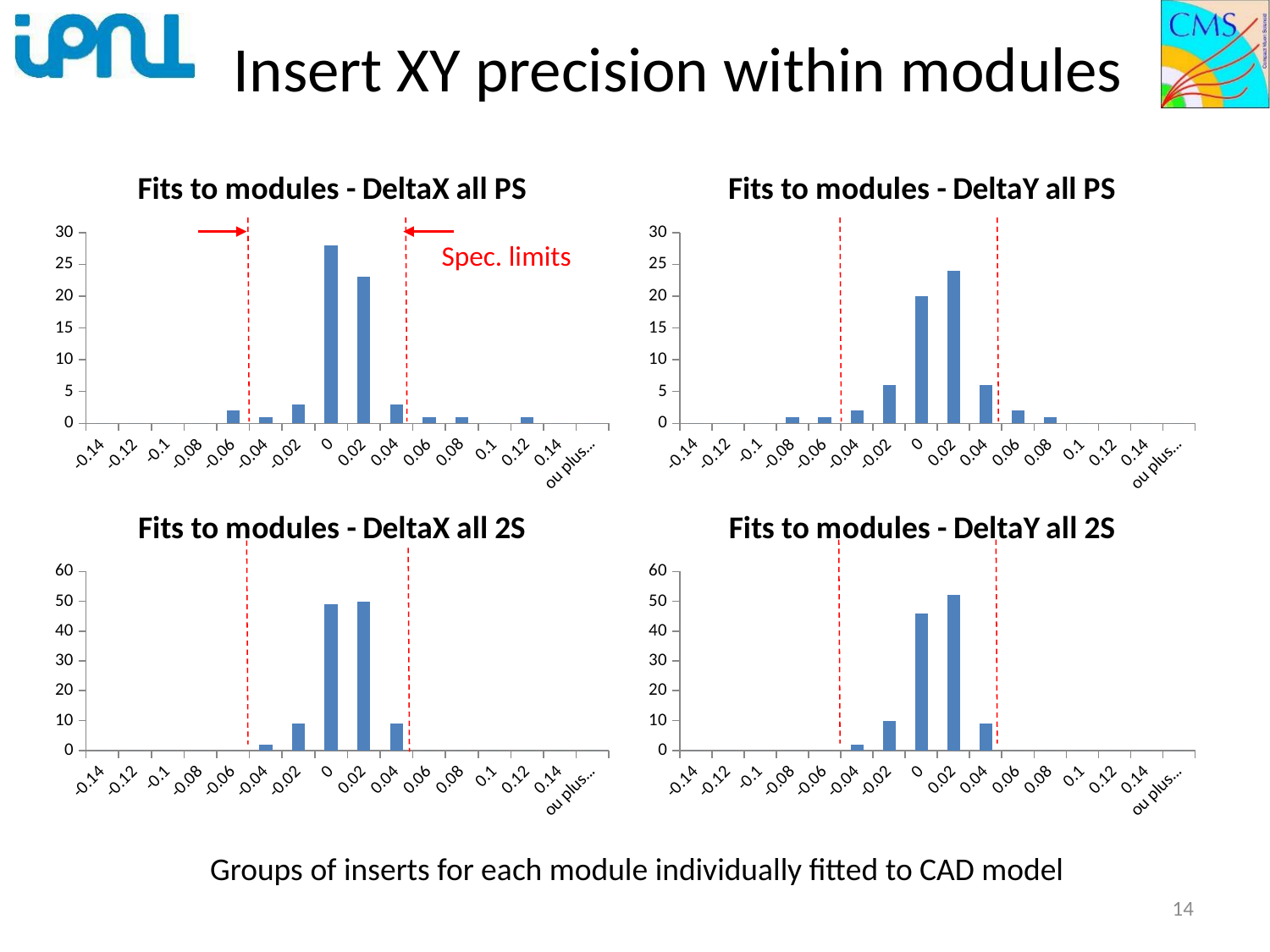
In the 'Fits to modules - DeltaY all PS' chart, is the value for the -0.02 bin greater or less than 5? greater What kind of chart is 'Fits to modules - DeltaX all PS'? bar chart In the 'Fits to modules - DeltaX all PS' chart, which x-axis bin has the tallest bar? 0 In the 'Fits to modules - DeltaY all 2S' chart, is the value for the 0 bin greater or less than 50? less In the 'Fits to modules - DeltaX all PS' chart, which bar is taller, the one at 0 or the one at 0.02? 0 In the 'Fits to modules - DeltaY all 2S' chart, which bar is taller, the one at 0 or the one at 0.02? 0.02 How many charts are shown on the slide? 4 What do the red dashed vertical lines on the charts represent, according to the label on the top-left chart? Spec. limits In the 'Fits to modules - DeltaY all PS' chart, which x-axis bin has the tallest bar? 0.02 In the 'Fits to modules - DeltaY all 2S' chart, which x-axis bin has the tallest bar? 0.02 In the 'Fits to modules - DeltaX all 2S' chart, is the value for the 0 bin greater or less than 40? greater